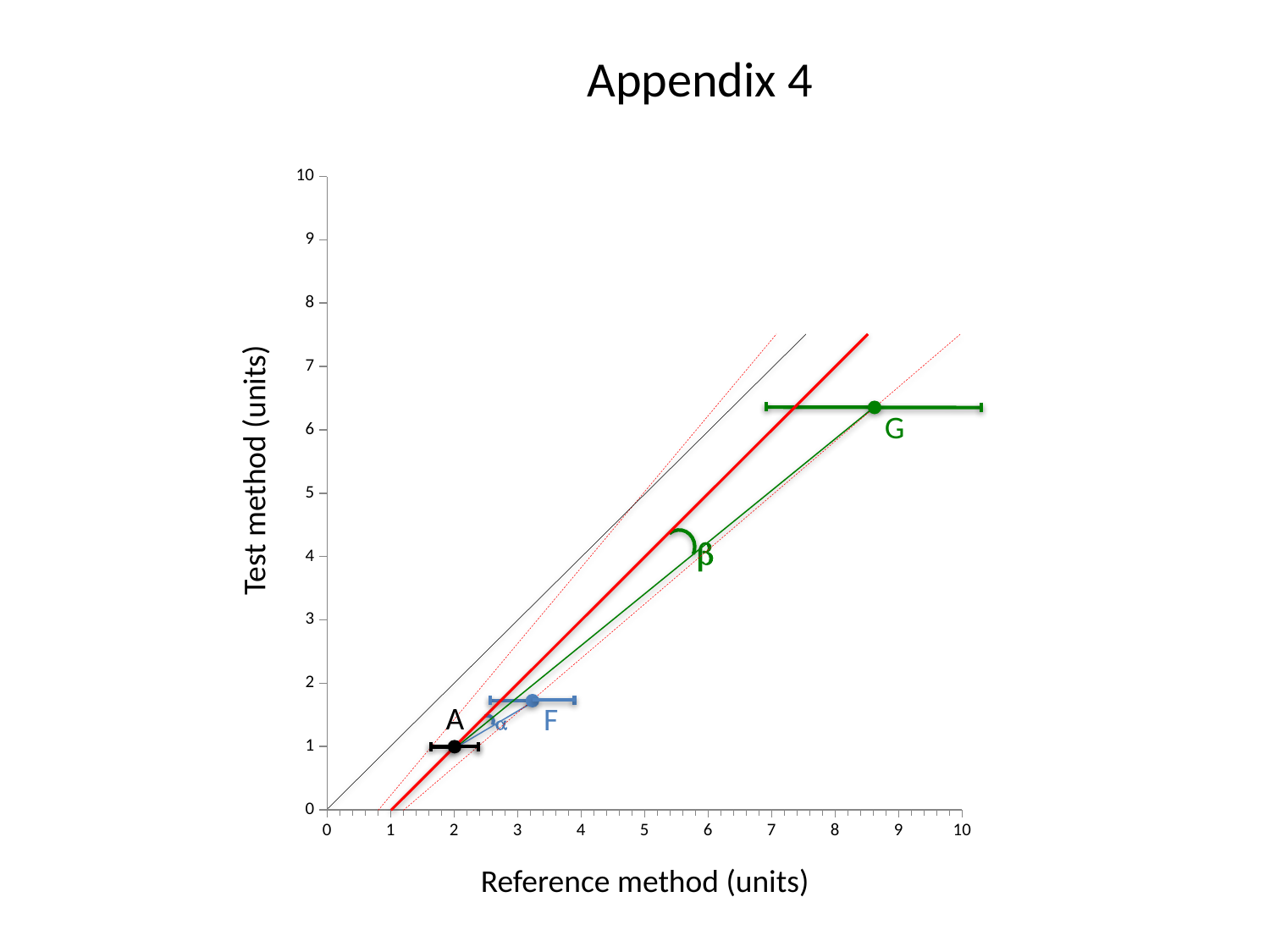
Which labeled point has the highest Test method value? G Is the Test method value for point G greater or less than 6? greater Is the Reference method value for point A greater or less than 3? less Is the Test method value for point F greater or less than 2? less What is the label of the x axis? Reference method (units) What kind of chart is shown on the slide? scatter chart How many labeled data points (A, F, G) are plotted on the chart? 3 What is the title of the slide containing the chart? Appendix 4 Which point has the larger Reference method value, F or G? G Which labeled point has the lowest Test method value? A What is the maximum value shown on the Test method (y) axis? 10